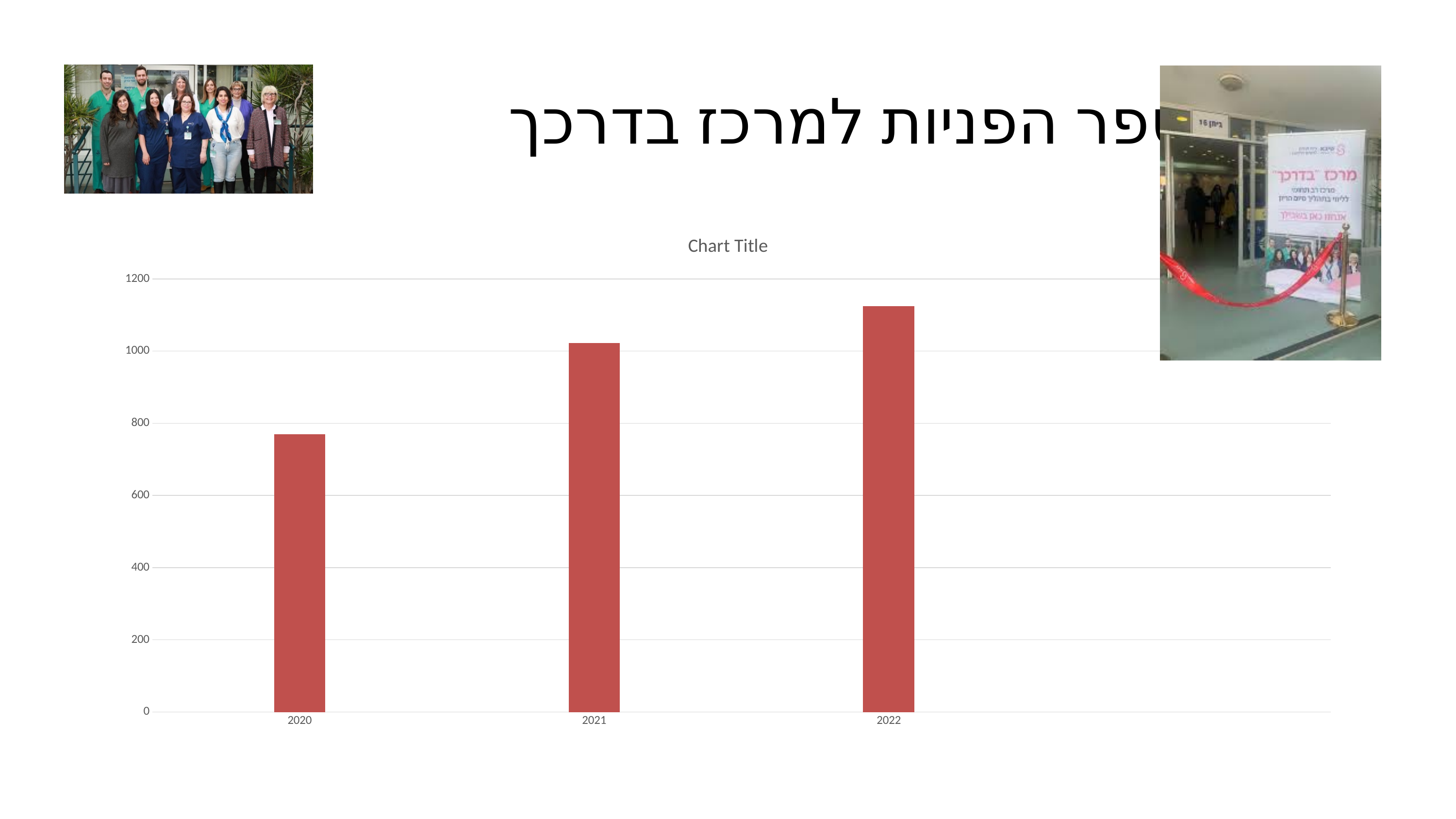
Which year has the lowest bar in the chart? 2020 Is the value for 2020 greater or less than 600? greater Is the value for 2022 greater or less than 1200? less What is the title shown above the chart? Chart Title Which is larger, the value for 2021 or the value for 2020? 2021 Do the values rise or fall from 2020 to 2022? rise Which is larger, the value for 2022 or the value for 2021? 2022 Is the value for 2020 greater or less than 800? less What kind of chart is shown on the slide? bar chart Which year has the highest bar in the chart? 2022 How many bars (categories) does the chart show? 3